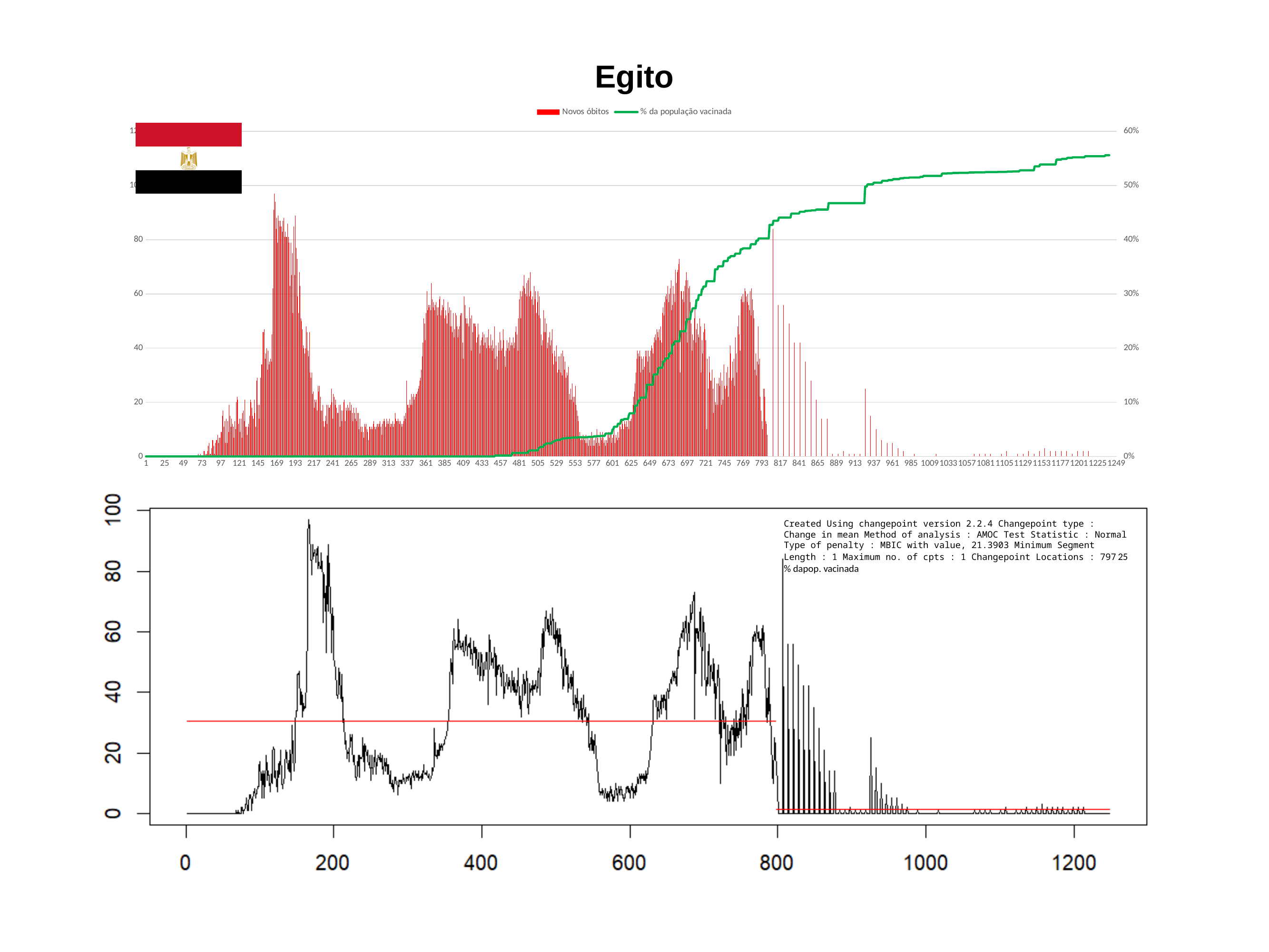
In the top chart, how many series does the legend list? 2 In the top chart, does the '% da população vacinada' line rise or fall along the x axis? Rises In the bottom chart, what is the changepoint location stated in the annotation text? 797 In the top chart, which colour is used for the '% da população vacinada' series? Green In the top chart, is the highest 'Novos óbitos' bar (around x = 169) greater or less than 80? greater In the top chart, what are the two legend entries? Novos óbitos; % da população vacinada In the top chart, is the final value of the '% da população vacinada' line greater or less than 50%? greater In the bottom chart, is the red mean line to the left of the changepoint greater or less than 20? greater In the bottom chart, what penalty value is stated in the annotation text? 21.3903 In the top chart, what is the highest tick label on the right-hand percentage axis? 60%